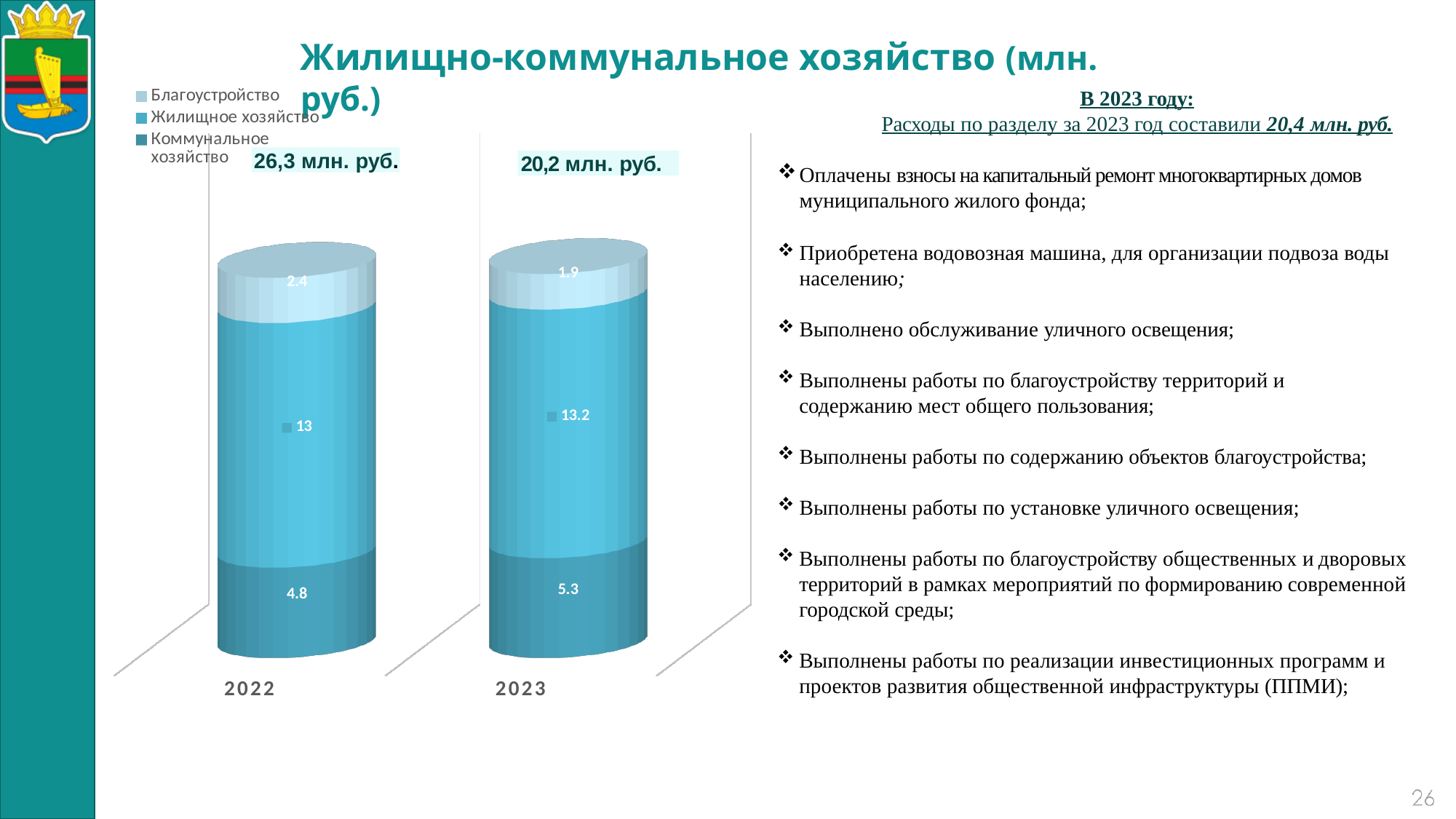
Which year has the larger value for Благоустройство, 2022 or 2023? 2022 What is the value for Благоустройство in 2022? 2.4 What is the value for Благоустройство in 2023? 1.9 How many series does the chart legend list? 3 How many years (categories) are shown on the x axis of the chart? 2 What is the value for Коммунальное хозяйство in 2022? 4.8 What kind of chart is shown on the slide? Stacked bar chart What is the value for Коммунальное хозяйство in 2023? 5.3 By how much did the value for Коммунальное хозяйство change from 2022 to 2023? 0.5 What is the value for Жилищное хозяйство in 2023? 13.2 Which series has the largest value in the 2022 bar? Жилищное хозяйство What total label is printed above the 2022 bar? 26,3 млн. руб.